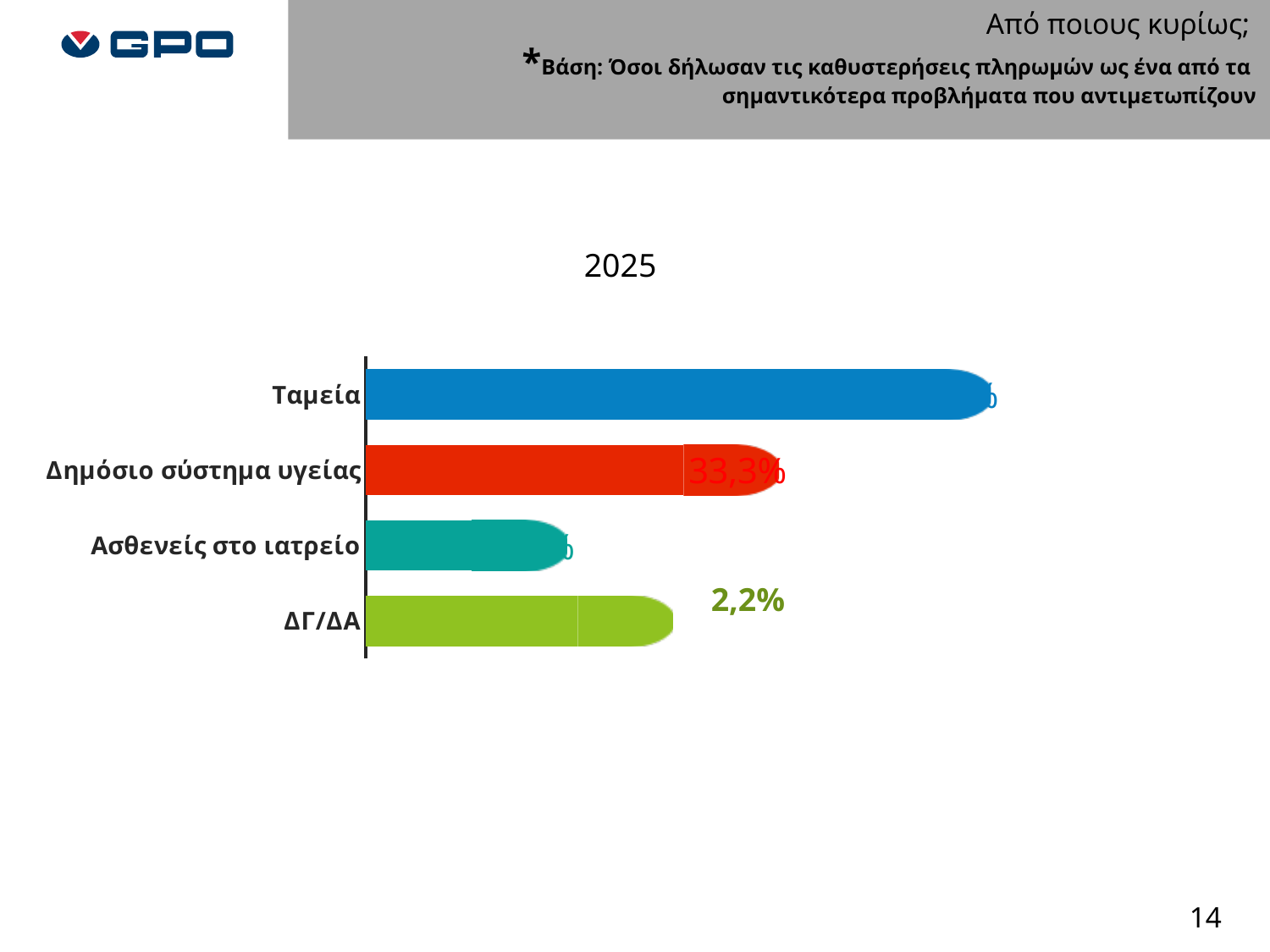
How many categories are shown in the chart? 4 Which is larger, Ταμεία or Δημόσιο σύστημα υγείας? Ταμεία What is the value for Δημόσιο σύστημα υγείας? 33,3% What is the title of the chart? 2025 What kind of chart is shown on the slide? Bar chart What colour is the bar for Ταμεία? Blue Which is larger, Δημόσιο σύστημα υγείας or ΔΓ/ΔΑ? Δημόσιο σύστημα υγείας What is the difference between the values for Δημόσιο σύστημα υγείας and ΔΓ/ΔΑ? 31,1% Which category has the highest value? Ταμεία What is the value for ΔΓ/ΔΑ? 2,2%